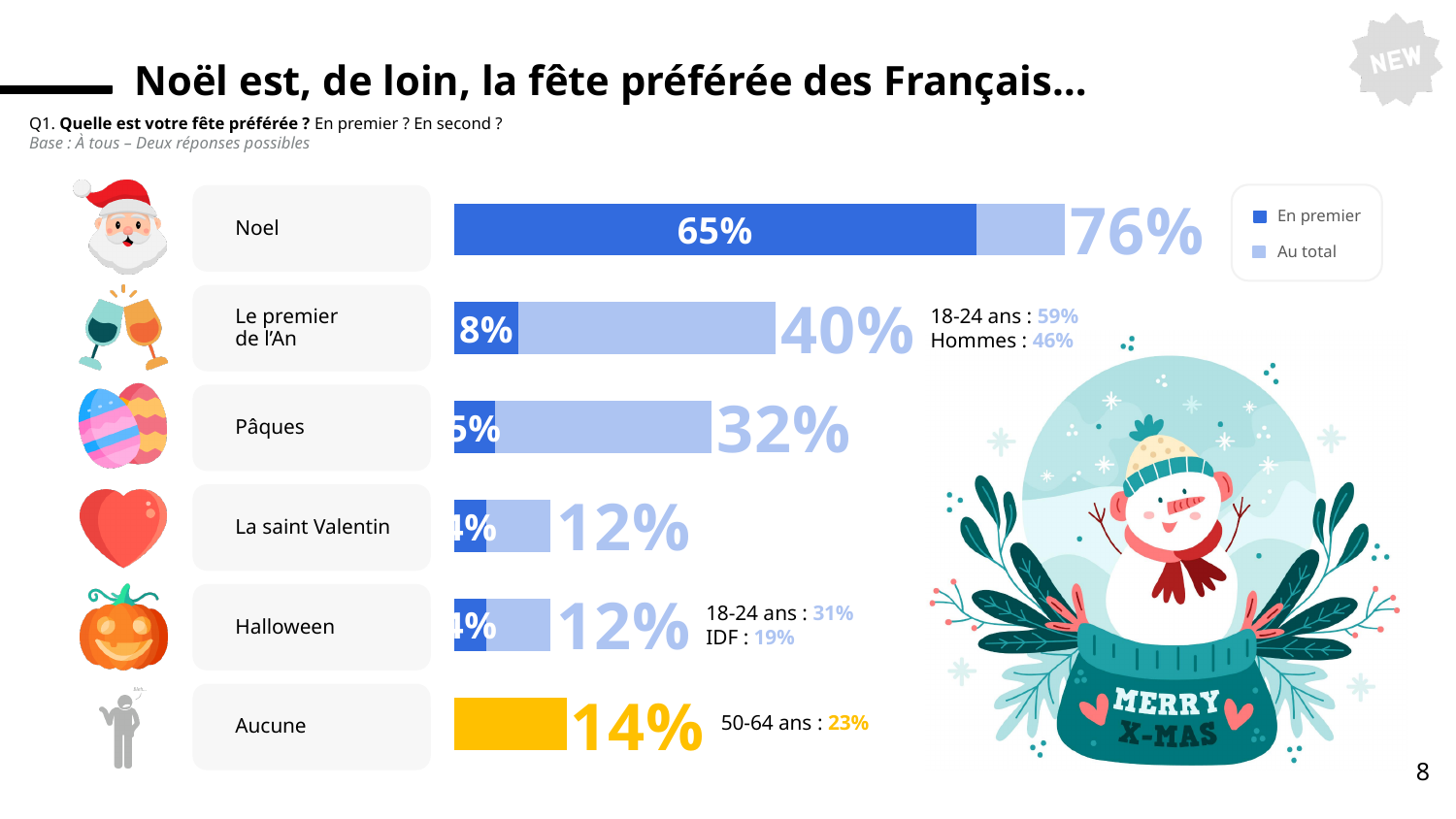
What is the 'Au total' value for Noel? 76% How many series does the legend list? 2 How many categories are shown in the chart? 6 What kind of chart is shown on the slide? Bar chart What is the value shown for Aucune? 14% Which is larger, the 'Au total' value for Pâques or for Le premier de l'An? Le premier de l'An What is the 'En premier' value for Noel? 65% What is the 'Au total' value for Pâques? 32% What is the difference between the 'Au total' and 'En premier' values for Noel? 11% Which category has the highest 'Au total' value? Noel What is the 'En premier' value for Le premier de l'An? 8% What is the 'Au total' value for Le premier de l'An? 40%